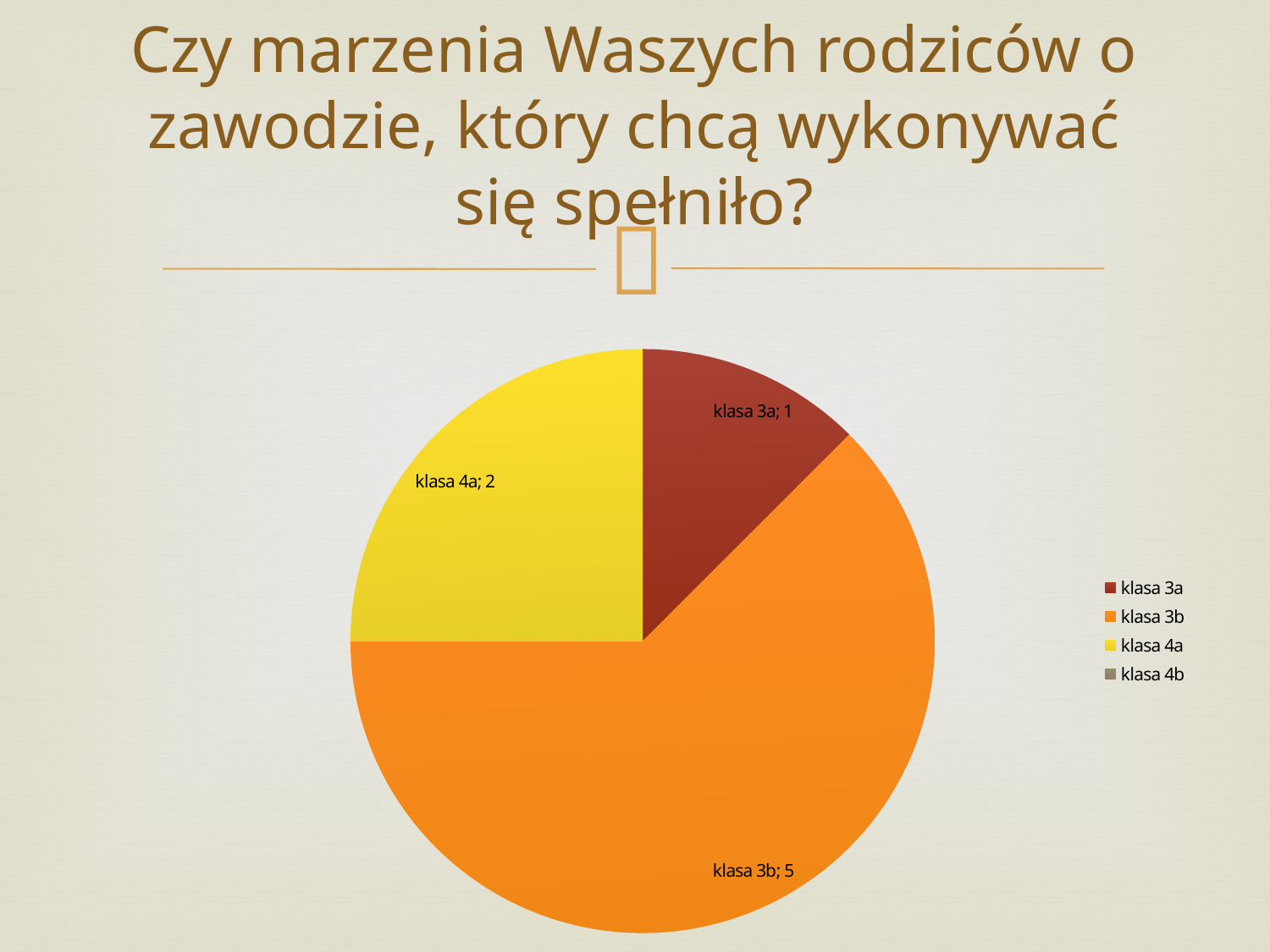
Which class has the largest slice of the pie? klasa 3b What is the value for klasa 4a? 2 Which class with a visible slice has the smallest value? klasa 3a What kind of chart is shown on the slide? pie chart How many entries does the legend list? 4 How many slices are visible in the pie chart? 3 What is the difference between the values for klasa 3b and klasa 4a? 3 What colour is the slice for klasa 4a? yellow What is the value for klasa 3b? 5 What is the difference between the values for klasa 4a and klasa 3a? 1 Which is larger, the value for klasa 4a or the value for klasa 3a? klasa 4a What is the value for klasa 3a? 1